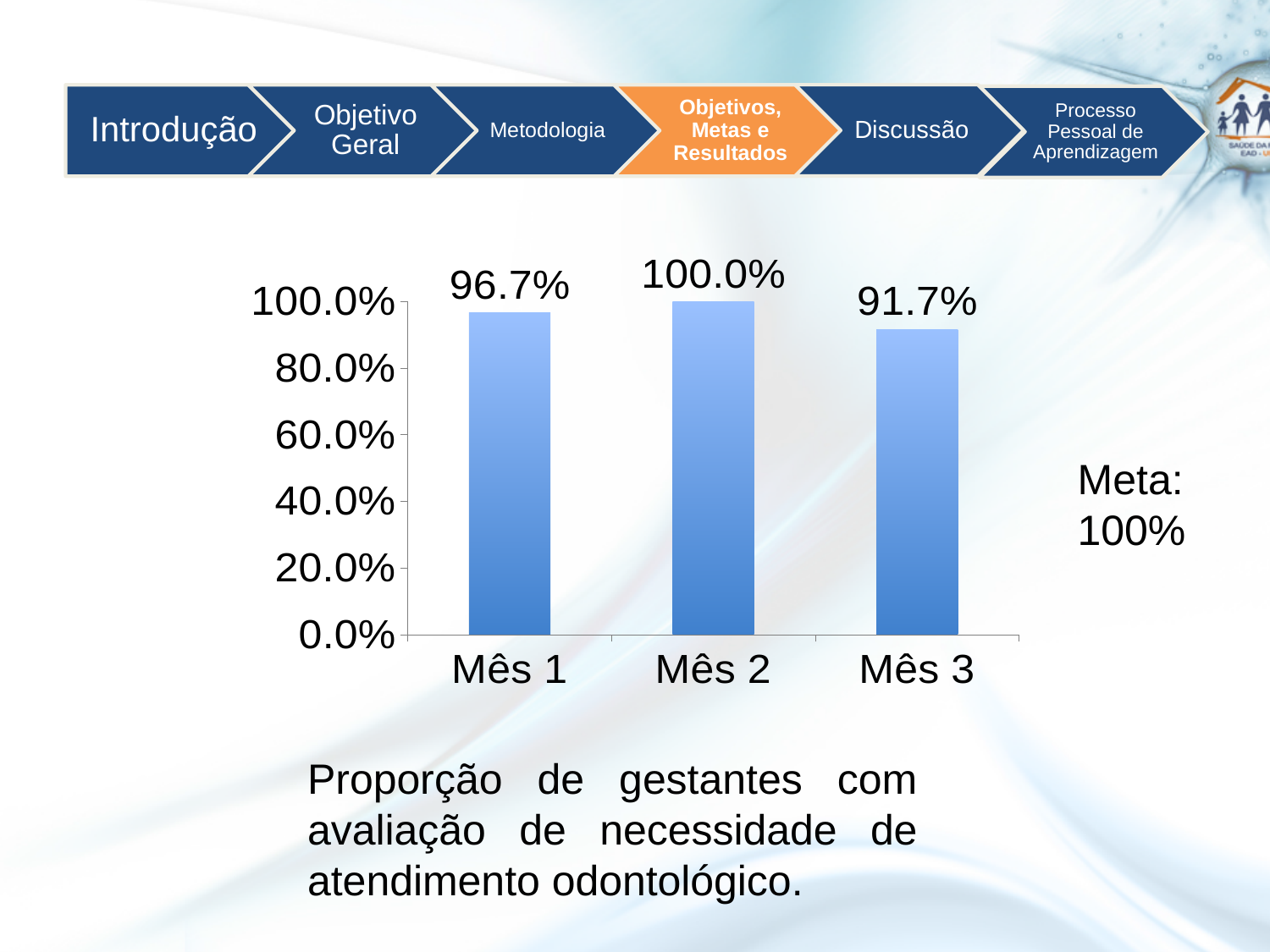
What is the value for Mês 1? 96.7% Is the value for Mês 3 greater or less than 80.0%? greater Which month has the lowest value? Mês 3 How many months are shown on the x axis? 3 What is the difference between the values for Mês 2 and Mês 3? 8.3% What is the value for Mês 3? 91.7% Which is larger, the value for Mês 1 or the value for Mês 3? Mês 1 Which month has the highest value? Mês 2 What is the difference between the values for Mês 1 and Mês 3? 5.0% What is the value for Mês 2? 100.0% What kind of chart is shown on the slide? bar chart What target (Meta) is stated next to the chart? 100%